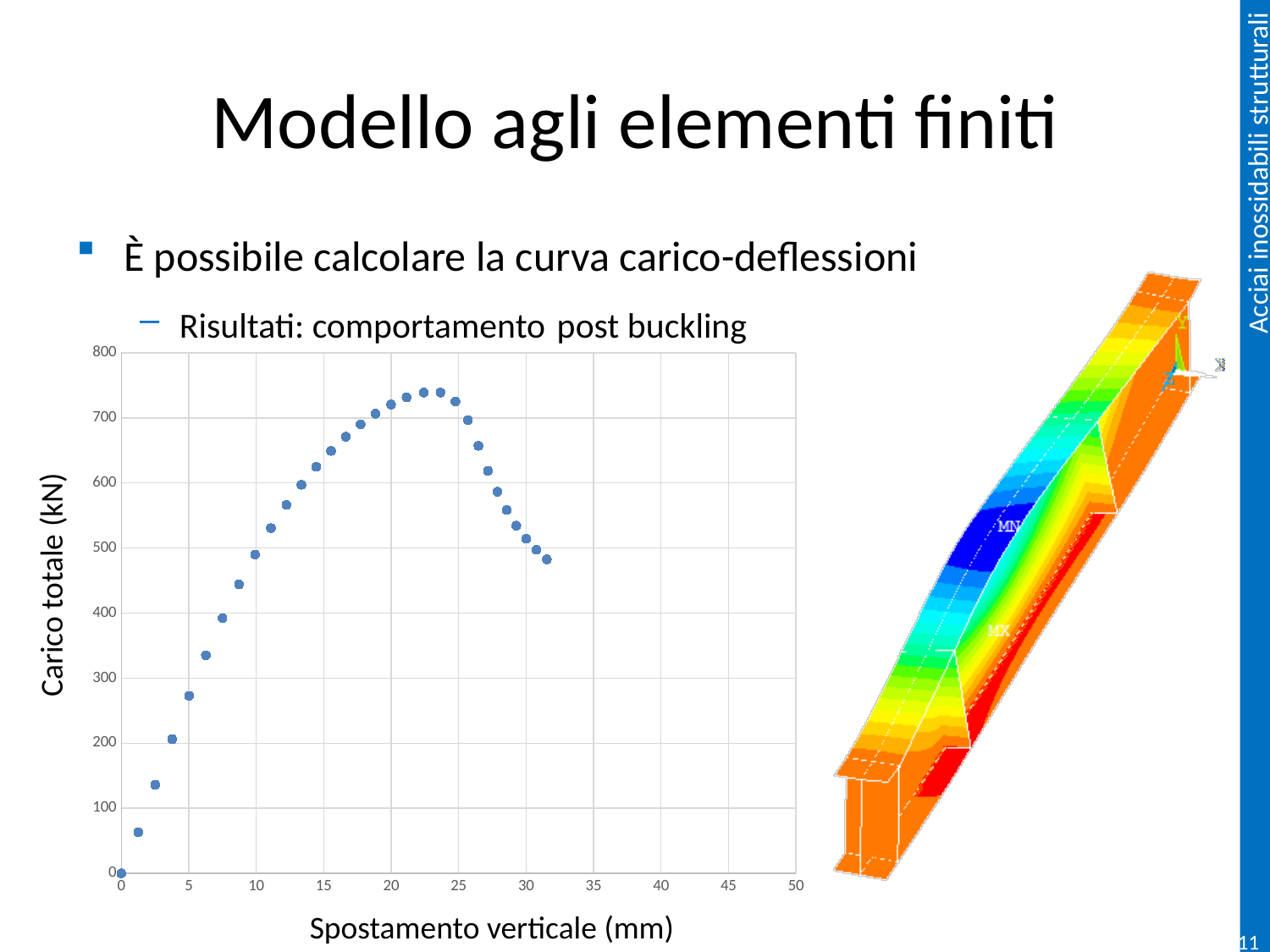
Do the plotted load values rise or fall as the vertical displacement increases from 0 mm to 20 mm? rise What kind of chart is shown on the slide? scatter chart Is the plotted load value at a vertical displacement of 20 mm greater or less than 700? greater Is the plotted load value at a vertical displacement of 5 mm greater or less than 300? less Do the plotted load values rise or fall as the vertical displacement increases from 25 mm to 30 mm? fall Is the load value of the last plotted point (at the largest displacement) greater or less than 600? less Is the plotted load value at a vertical displacement of 10 mm larger or smaller than the value at 5 mm? larger What is the title of the vertical axis of the chart? Carico totale (kN) What is the title of the horizontal axis of the chart? Spostamento verticale (mm)